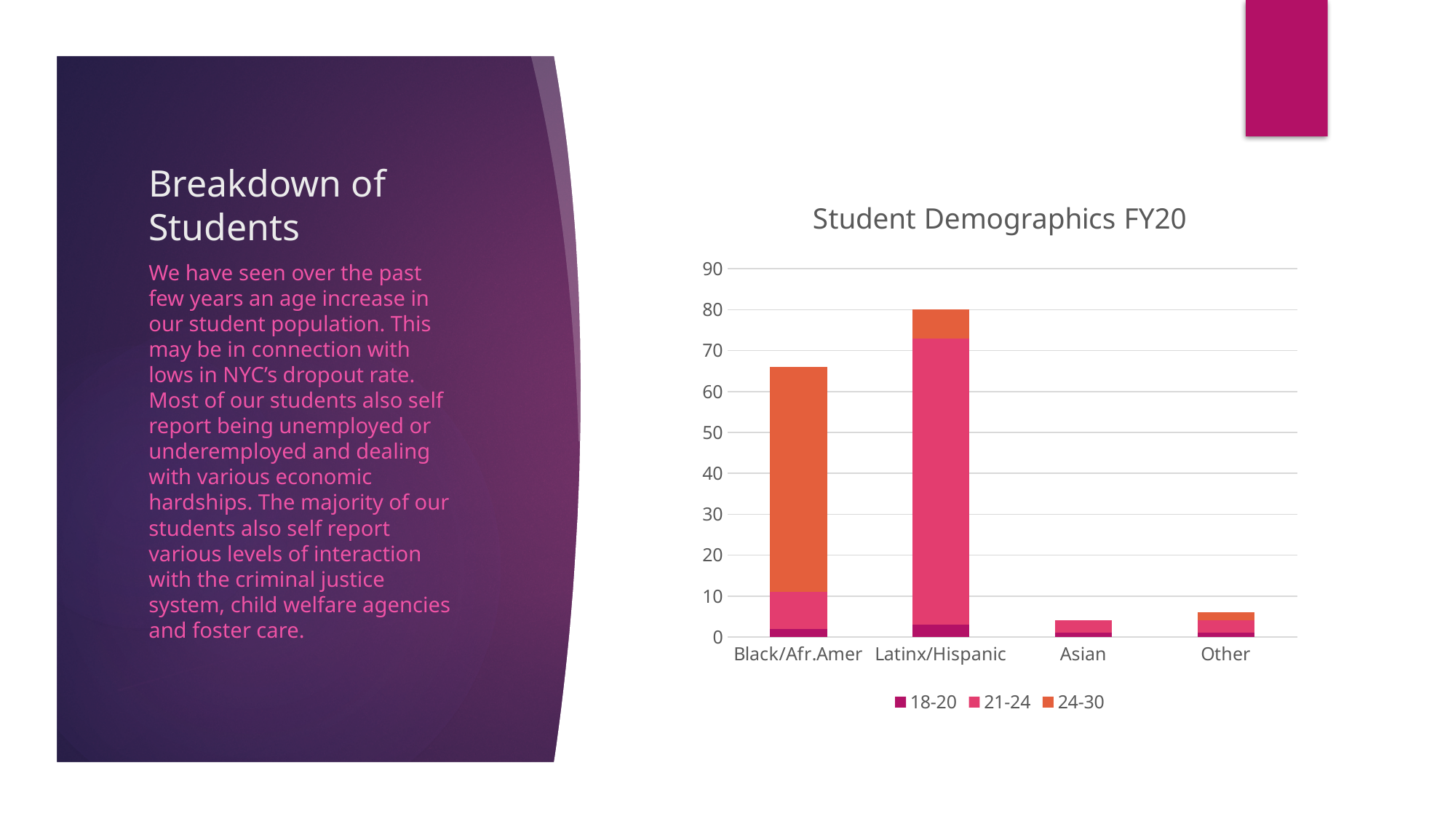
Which age group makes up the largest part of the Black/Afr.Amer bar? 24-30 How many series does the legend list? 3 Which stacked bar is taller, Black/Afr.Amer or Latinx/Hispanic? Latinx/Hispanic What type of chart is shown on the slide? Stacked bar chart Which category has the tallest stacked bar? Latinx/Hispanic What is the title of the chart? Student Demographics FY20 Is the total for Latinx/Hispanic greater or less than 70? greater How many categories are shown on the x axis of the chart? 4 Is the total for Black/Afr.Amer greater or less than 70? less Which age group makes up the largest part of the Latinx/Hispanic bar? 21-24 Is the total for Asian greater or less than 10? less